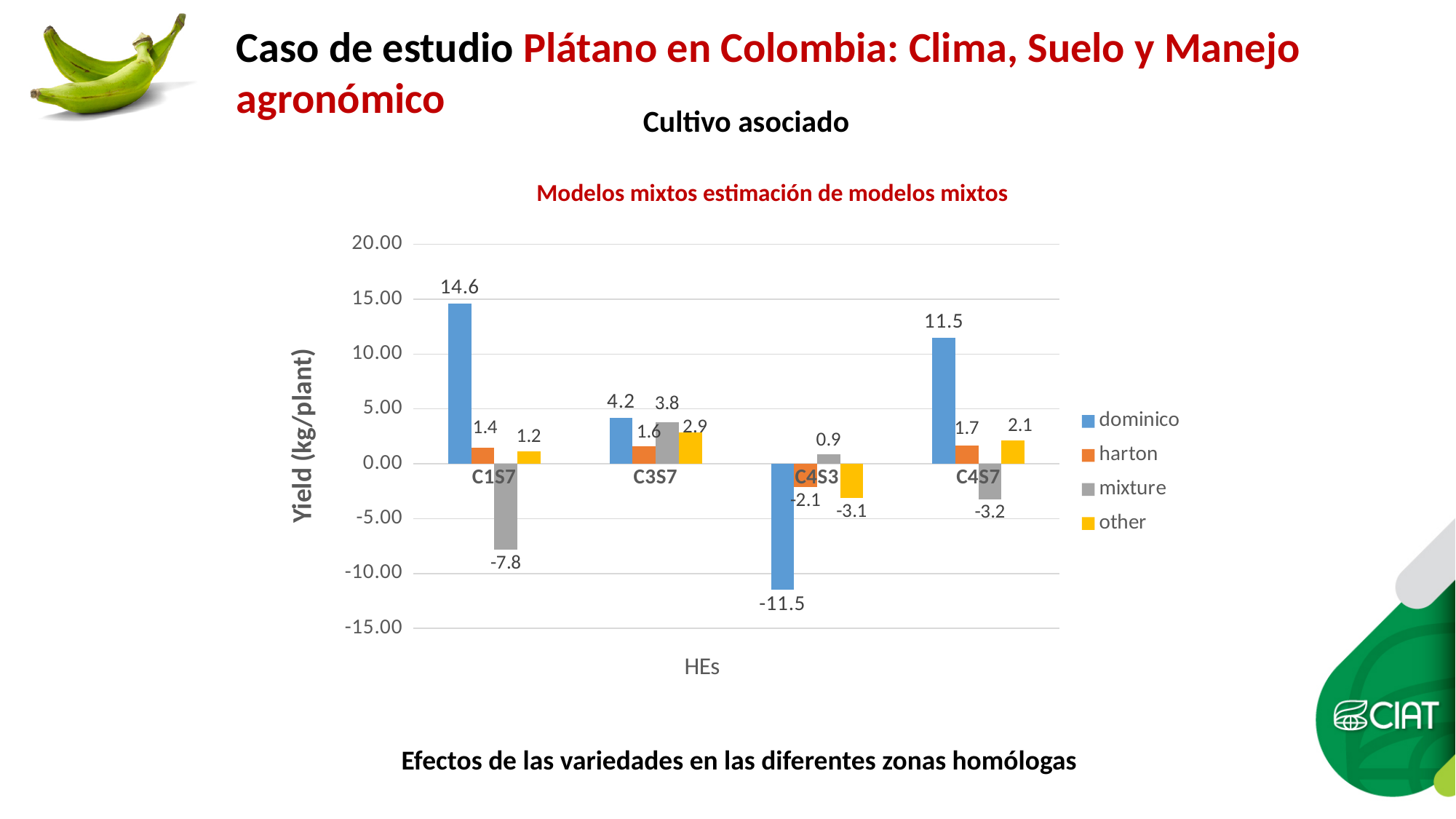
Which category has the lowest dominico value? C4S3 Which is larger at C3S7, the dominico value or the mixture value? dominico Which category has the highest dominico value? C1S7 How many series does the legend list? 4 What is the value for dominico at C4S3? -11.5 What is the label of the y axis? Yield (kg/plant) What kind of chart is shown on the slide? bar chart What is the value for mixture at C1S7? -7.8 What is the value for other at C3S7? 2.9 How many categories are shown on the x axis? 4 What is the difference between the dominico values at C1S7 and C4S7? 3.1 What is the value for dominico at C1S7? 14.6